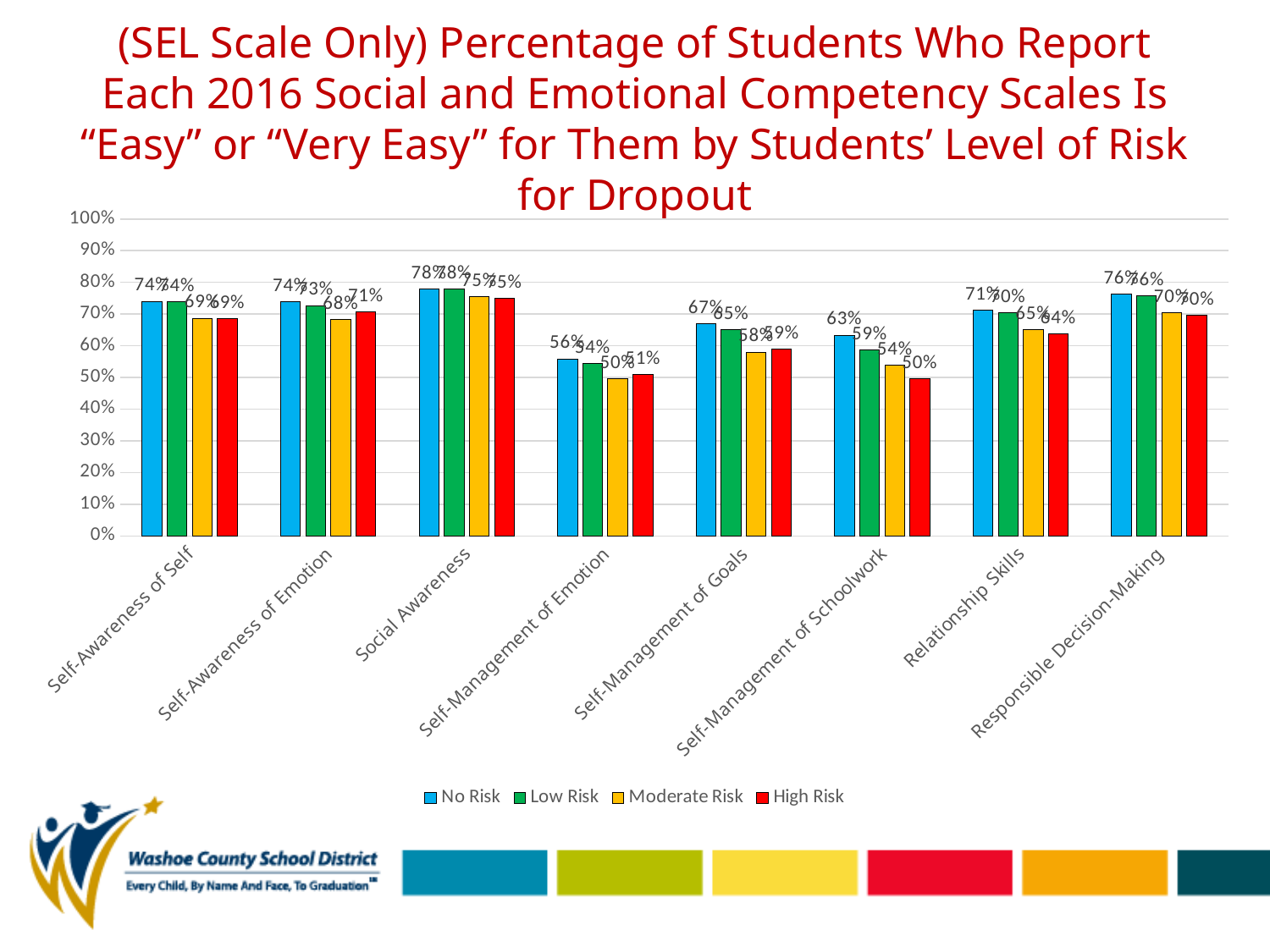
What type of chart is shown on the slide? Bar chart What is the value for Low Risk students on the Self-Management of Schoolwork scale? 59% What percentage of No Risk students report Self-Management of Schoolwork is easy or very easy? 63% Is the value for Moderate Risk students on the Self-Management of Emotion scale greater or less than 60%? less What is the value for Moderate Risk students on the Self-Awareness of Emotion scale? 68% How many competency scales are shown on the x axis? 8 What is the value for High Risk students on the Self-Management of Schoolwork scale? 50% Which competency scale has the lowest value for No Risk students? Self-Management of Emotion For No Risk students, which is larger: the value for Self-Management of Goals or the value for Relationship Skills? Relationship Skills On the Self-Management of Schoolwork scale, how many percentage points higher is the No Risk value than the High Risk value? 13 percentage points How many risk levels does the legend list? 4 Which competency scale has the highest value for No Risk students? Social Awareness